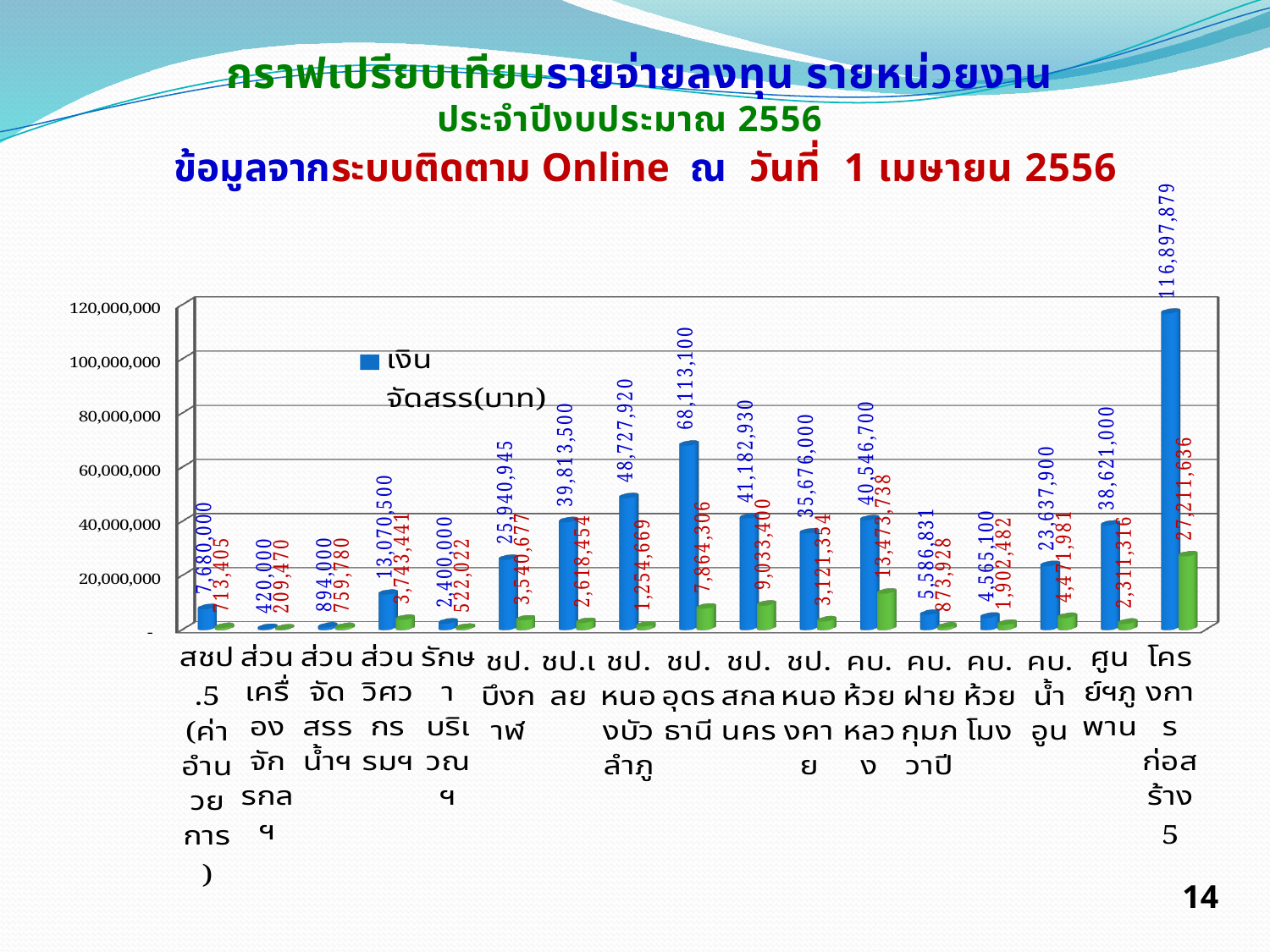
What is the เงินจัดสรร(บาท) value (blue bar) for ศูนย์ฯภูพาน? 38,621,000 What is the value printed in red for คบ.ห้วยหลวง? 13,473,738 What series name is shown in the chart legend? เงินจัดสรร(บาท) Which has the larger blue-bar value, ชป.สกลนคร or คบ.ห้วยหลวง? ชป.สกลนคร Which unit has the lowest เงินจัดสรร(บาท) (blue bar)? ส่วนเครื่องจักรกลฯ For โครงการก่อสร้าง 5, what is the difference between the blue-bar value and the red-labelled value? 89,686,243 What kind of chart is shown on the slide? Bar chart What is the เงินจัดสรร(บาท) value (blue bar) for ชป.อุดรธานี? 68,113,100 Is the blue-bar value for ชป.หนองบัวลำภู greater or less than 40,000,000? greater How many units (categories) are shown on the x axis? 17 Which unit has the highest เงินจัดสรร(บาท) (blue bar)? โครงการก่อสร้าง 5 What is the difference between the blue-bar values for ชป.เลย and ชป.หนองคาย? 4,137,500